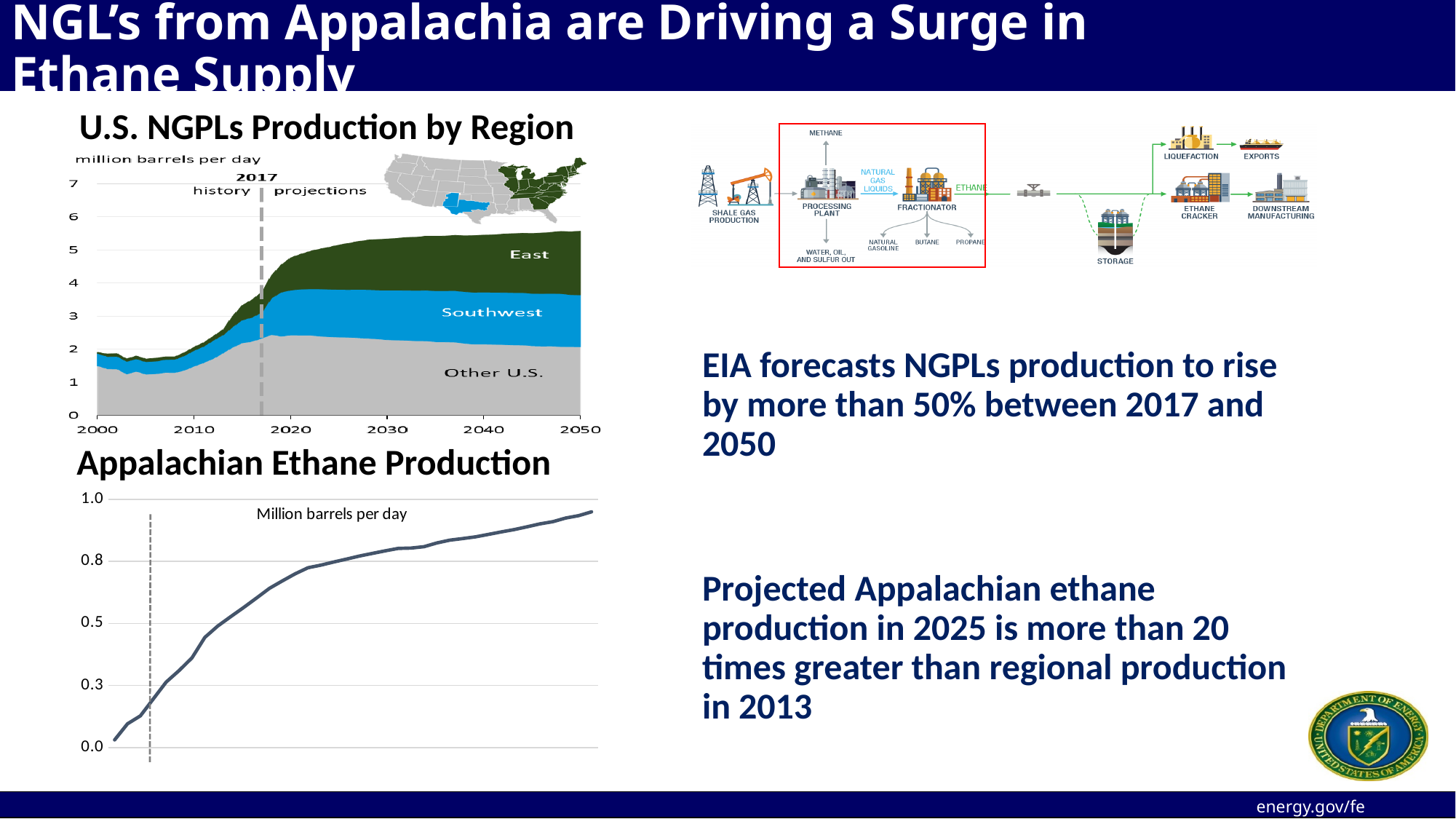
In the 'Appalachian Ethane Production' chart, is the value at the end of the line greater or less than 0.8 million barrels per day? greater In the 'U.S. NGPLs Production by Region' chart, what year does the dashed line separating history from projections mark? 2017 In the 'U.S. NGPLs Production by Region' chart, how many regions are plotted? 3 In the 'Appalachian Ethane Production' chart, what is the highest value shown on the y axis? 1.0 In the 'U.S. NGPLs Production by Region' chart, is total production in 2000 greater or less than 3 million barrels per day? less In the 'U.S. NGPLs Production by Region' chart, is total production in 2050 greater or less than 5 million barrels per day? greater In the 'U.S. NGPLs Production by Region' chart, does total production rise or fall from 2000 to 2050? rise In the 'U.S. NGPLs Production by Region' chart, which regions are labelled on the areas? East, Southwest, Other U.S. In the 'Appalachian Ethane Production' chart, does production rise or fall over time? rise What kind of chart is the 'U.S. NGPLs Production by Region' chart? stacked area chart What kind of chart is the 'Appalachian Ethane Production' chart? line chart